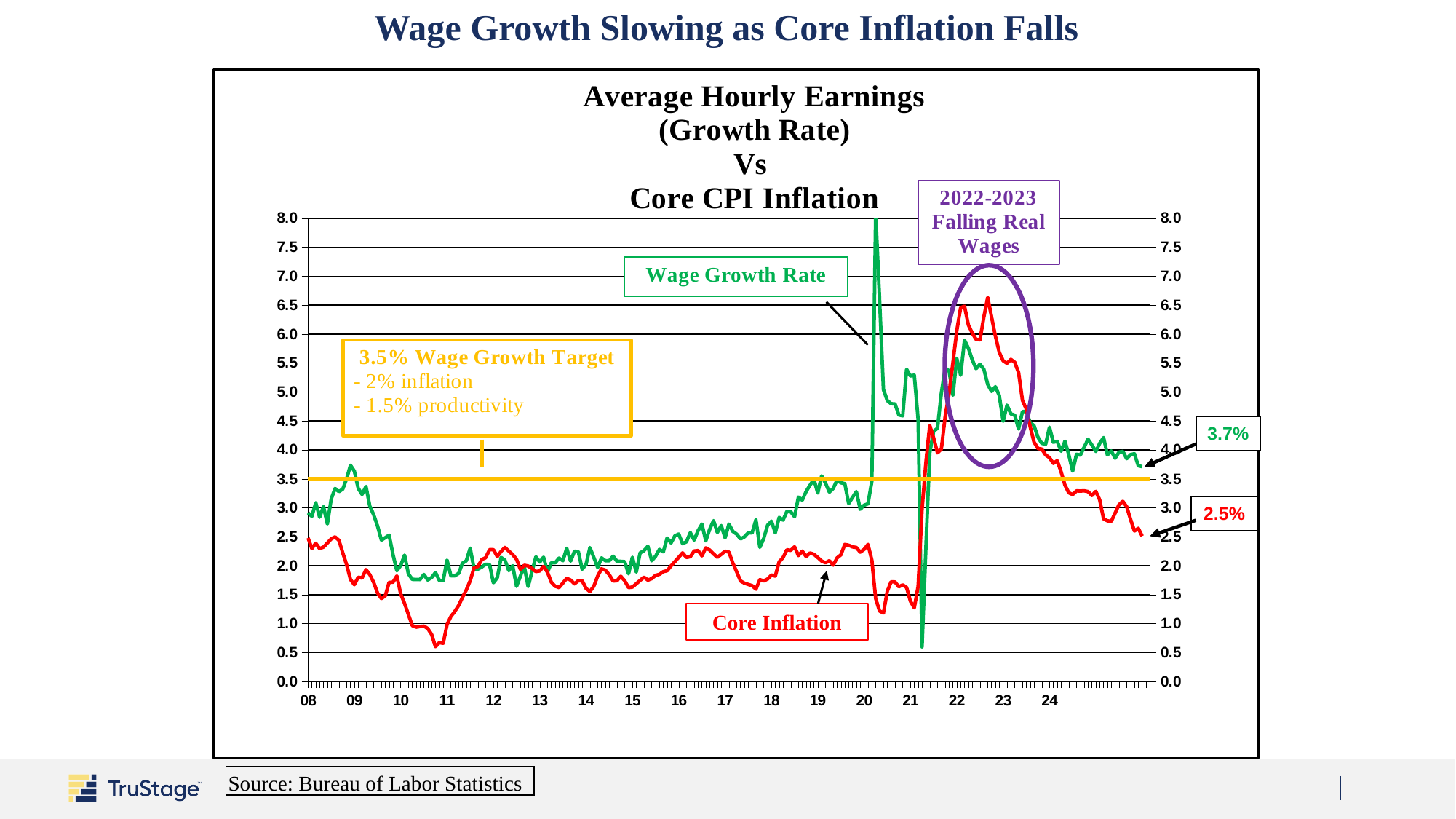
What is the difference between the latest labeled Wage Growth Rate (3.7%) and the latest labeled Core Inflation (2.5%)? 1.2% At the right end of the chart, which series is higher: Wage Growth Rate or Core Inflation? Wage Growth Rate Is the latest Wage Growth Rate value greater or less than 3.5? greater Which years are circled and labeled as 'Falling Real Wages'? 2022-2023 What kind of chart is shown on the slide? line chart What is the latest labeled value of the Wage Growth Rate at the right end of the chart? 3.7% How many data series (lines) are labeled on the chart, excluding the target line? 2 From 2022 to the end of the chart, does the Wage Growth Rate line rise or fall? fall Is the peak of the Wage Growth Rate line around 2020 greater or less than 7.5? greater What is the latest labeled value of Core Inflation at the right end of the chart? 2.5% What is the wage growth target value shown by the horizontal yellow line? 3.5% Is the lowest point of the Core Inflation line around 2011 greater or less than 1.0? less